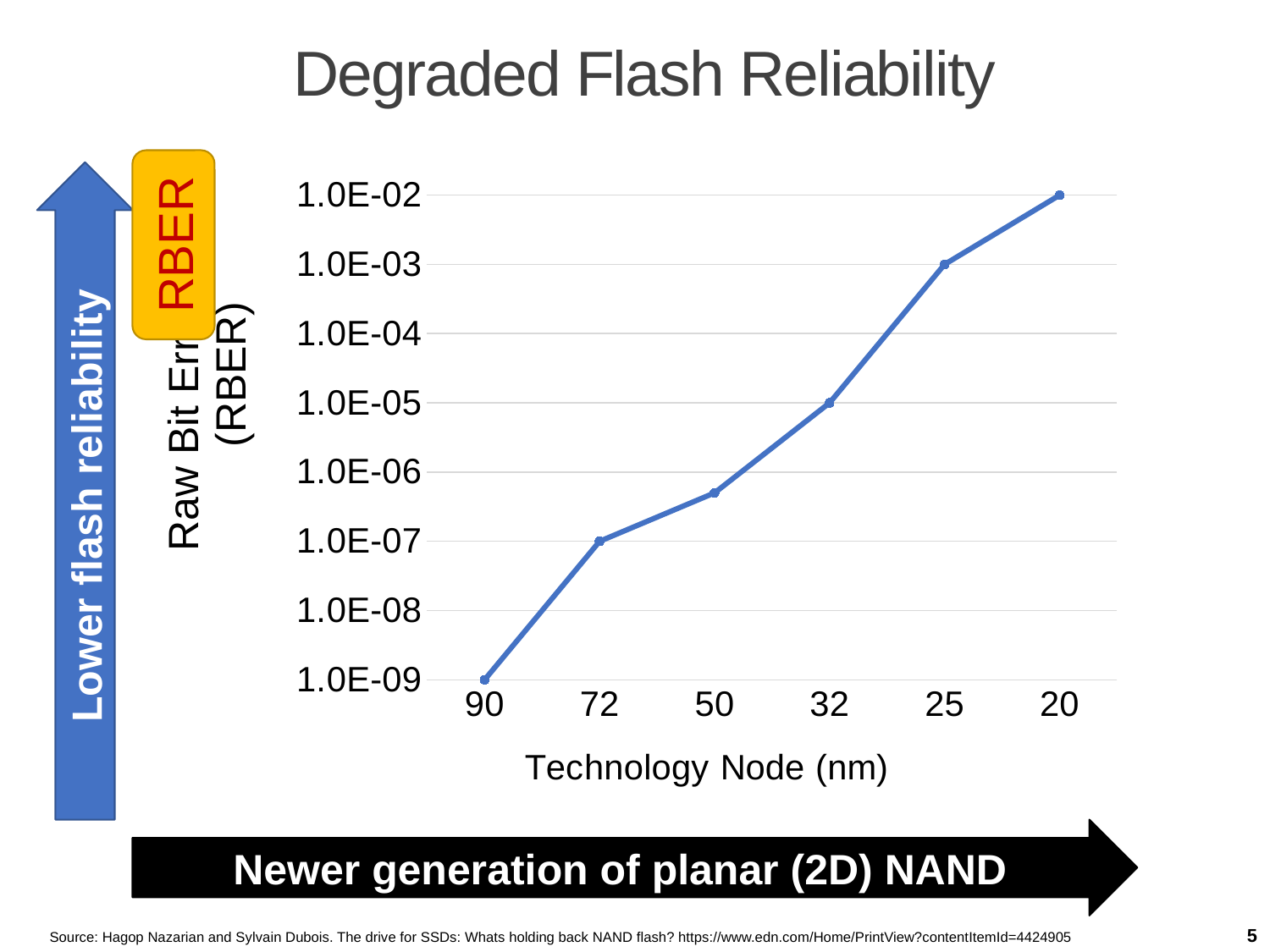
What is the title of the x axis? Technology Node (nm) What is the RBER value at the 25 nm technology node? 1.0E-03 Which technology node has the lowest RBER? 90 Is the RBER value at the 50 nm node greater or less than 1.0E-06? less Does the RBER rise or fall moving from left to right along the x axis? rise What is the RBER value at the 20 nm technology node? 1.0E-02 What is the RBER value at the 90 nm technology node? 1.0E-09 Which technology node has the highest RBER? 20 What is the RBER value at the 32 nm technology node? 1.0E-05 What kind of chart is shown on the slide? line chart What is the RBER value at the 72 nm technology node? 1.0E-07 How many technology node points are plotted on the x axis? 6